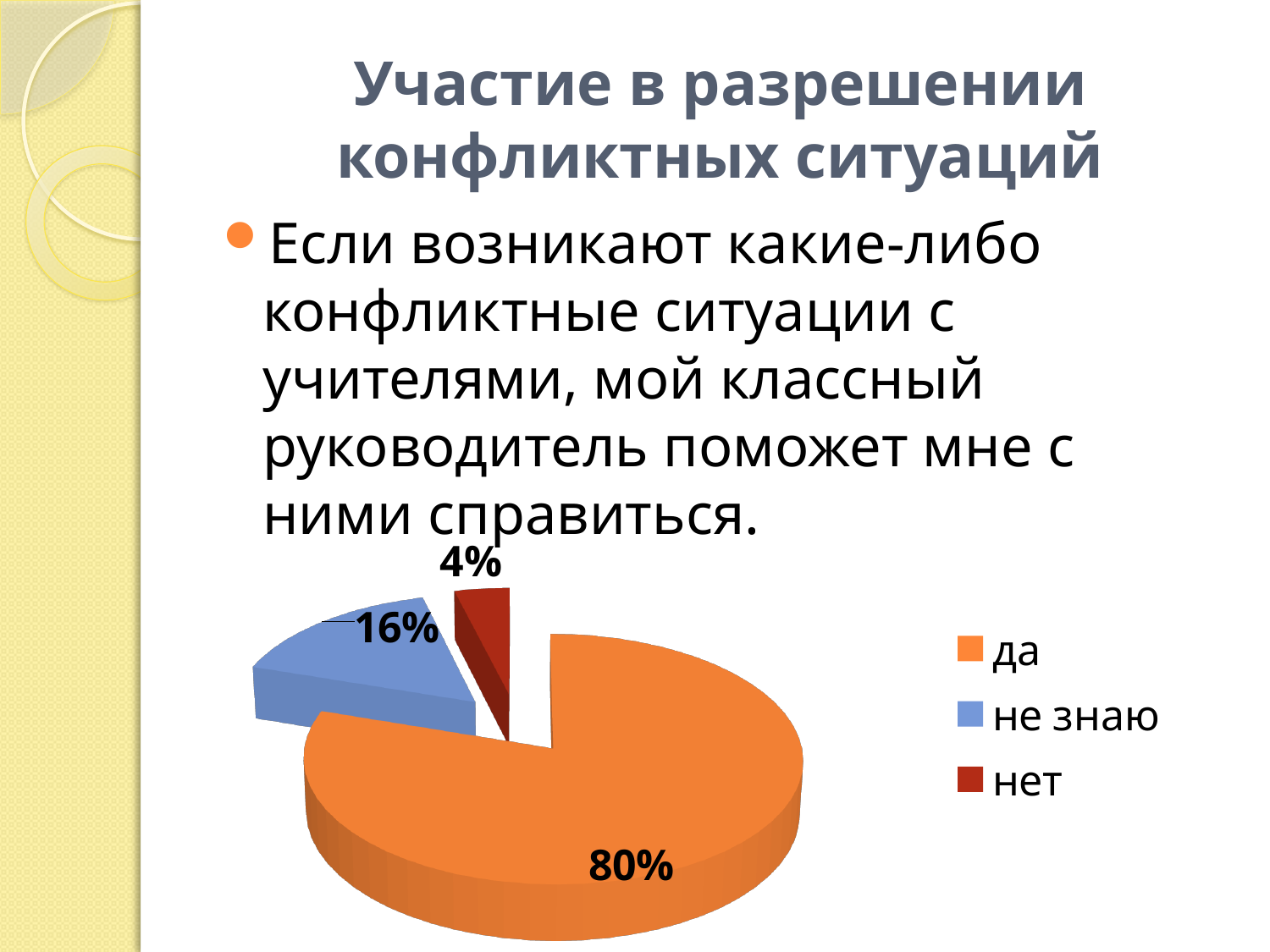
How many categories does the pie chart have? 3 Which category is shown in blue in the legend? не знаю What is the difference in percentage points between "да" and "не знаю"? 64 What percentage of the pie is labelled "не знаю"? 16% What percentage of the pie is labelled "нет"? 4% What kind of chart is shown on the slide? pie chart Which is larger, the share for "не знаю" or the share for "нет"? не знаю What colour is the slice for "да"? orange Which category has the largest share of the pie? да Which category has the smallest share of the pie? нет What percentage of the pie is labelled "да"? 80% What is the difference in percentage points between "не знаю" and "нет"? 12